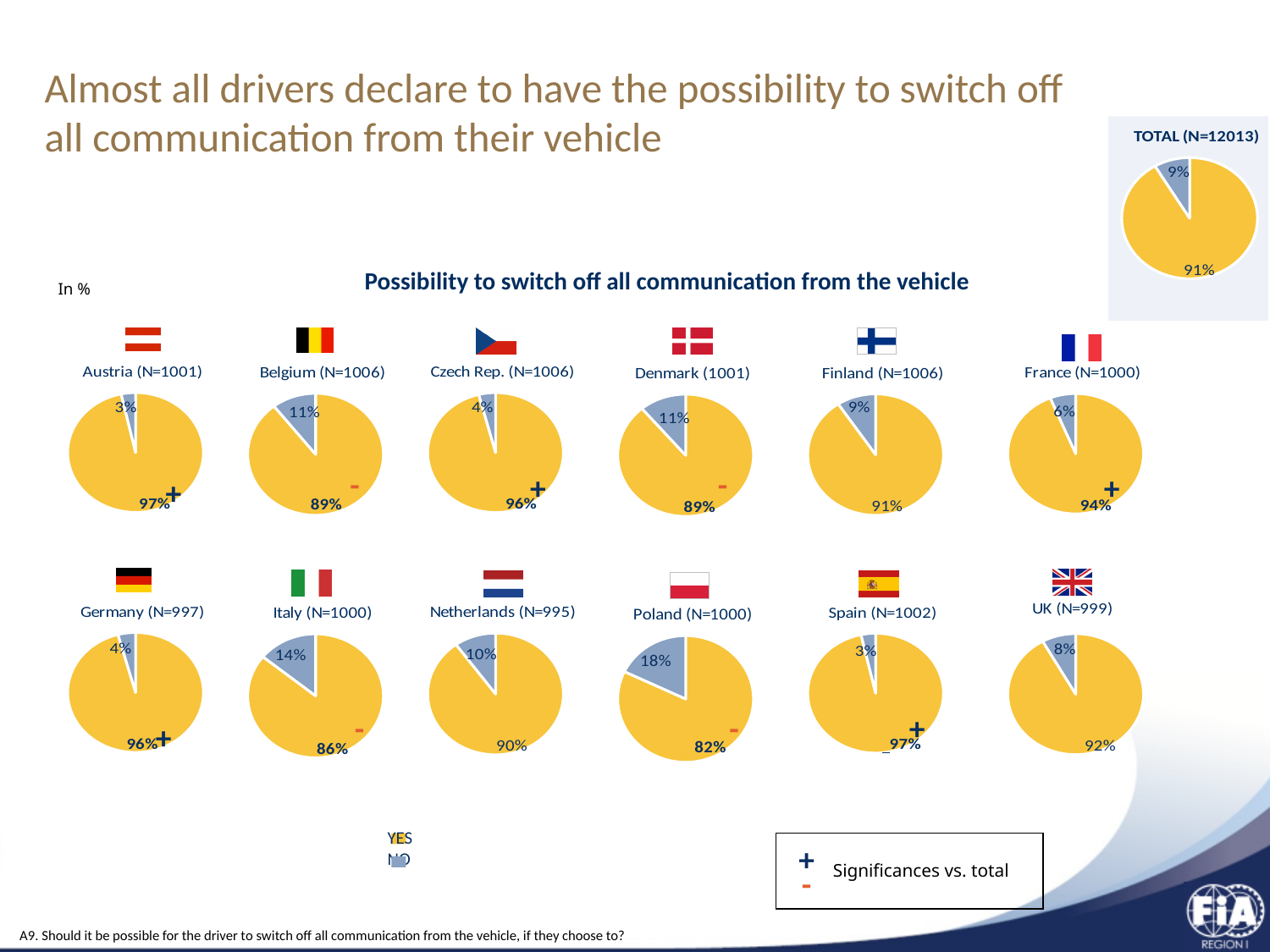
What type of chart is used for each country on this slide? Pie chart In the Italy (N=1000) pie chart, what share of the pie is YES? 86% In the Spain (N=1002) pie chart, what percentage of drivers answered NO? 3% Across the country pie charts, which country has the largest NO slice? Poland In the TOTAL (N=12013) pie chart, what percentage of drivers answered YES? 91% How many pie charts are shown on the slide in total, including the TOTAL chart? 13 How many series does the legend at the bottom of the slide list? 2 What colour represents the YES answer in the pie charts? Yellow Which has a larger NO slice, the Germany (N=997) pie chart or the Netherlands (N=995) pie chart? Netherlands Across the country pie charts, which country has the smallest YES slice? Poland What is the difference between the YES percentage in the Austria (N=1001) pie chart and the YES percentage in the Belgium (N=1006) pie chart? 8 percentage points In the Poland (N=1000) pie chart, what percentage of drivers answered NO? 18%